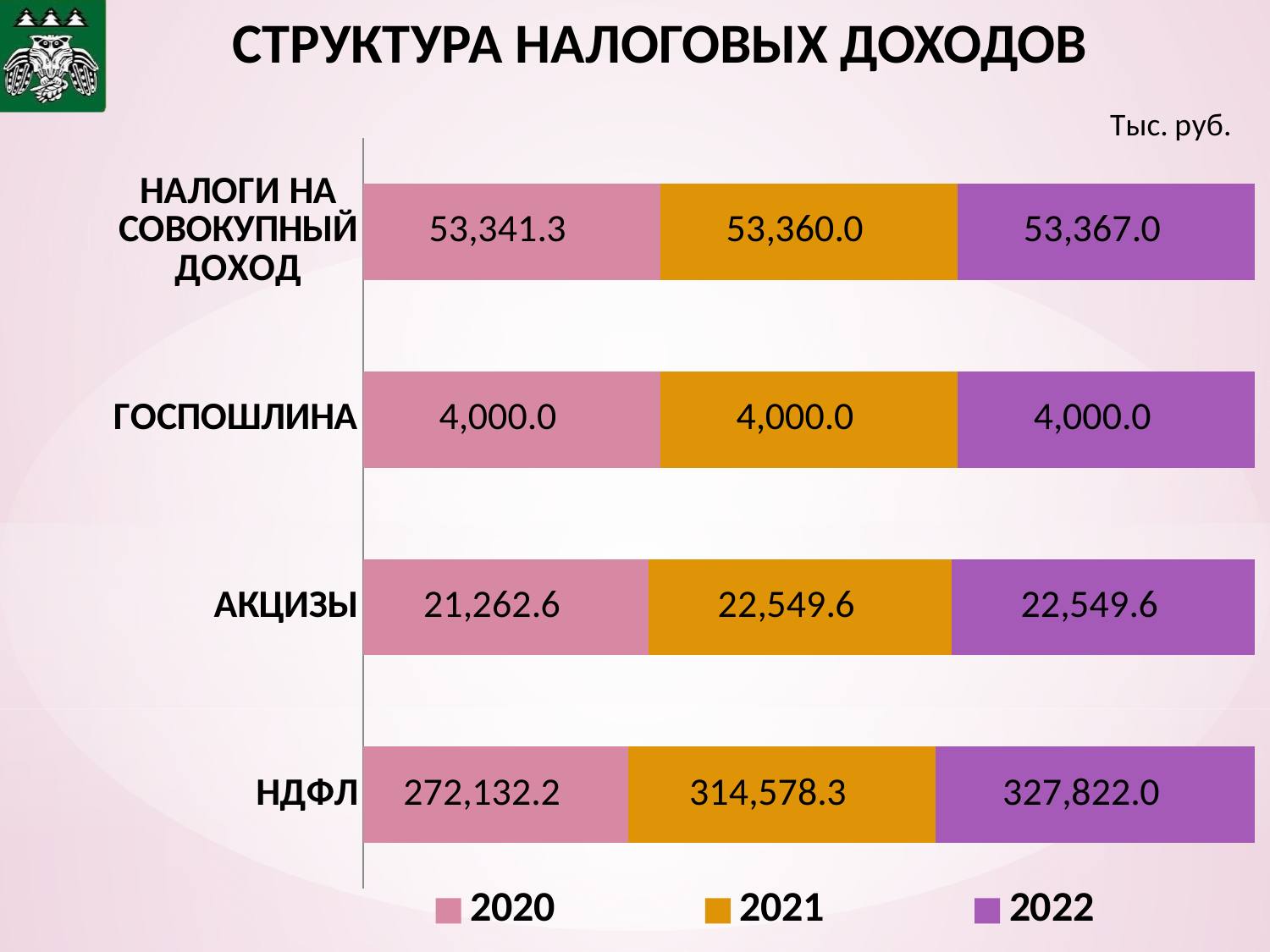
What is the value for ГОСПОШЛИНА in 2020? 4,000.0 What is the value for АКЦИЗЫ in 2021? 22,549.6 How many categories are shown in the chart? 4 What is the difference between the 2021 and 2020 values for АКЦИЗЫ? 1,287.0 Which is larger: the 2021 value for НДФЛ or the 2021 value for АКЦИЗЫ? НДФЛ Do the values for НДФЛ rise or fall from 2020 to 2022? rise Which category has the highest value in 2022? НДФЛ Which category has the lowest value in 2021? ГОСПОШЛИНА How many series does the legend list? 3 What is the value for НДФЛ in 2020? 272,132.2 What is the value for НАЛОГИ НА СОВОКУПНЫЙ ДОХОД in 2022? 53,367.0 What is the difference between the 2022 and 2020 values for НДФЛ? 55,689.8